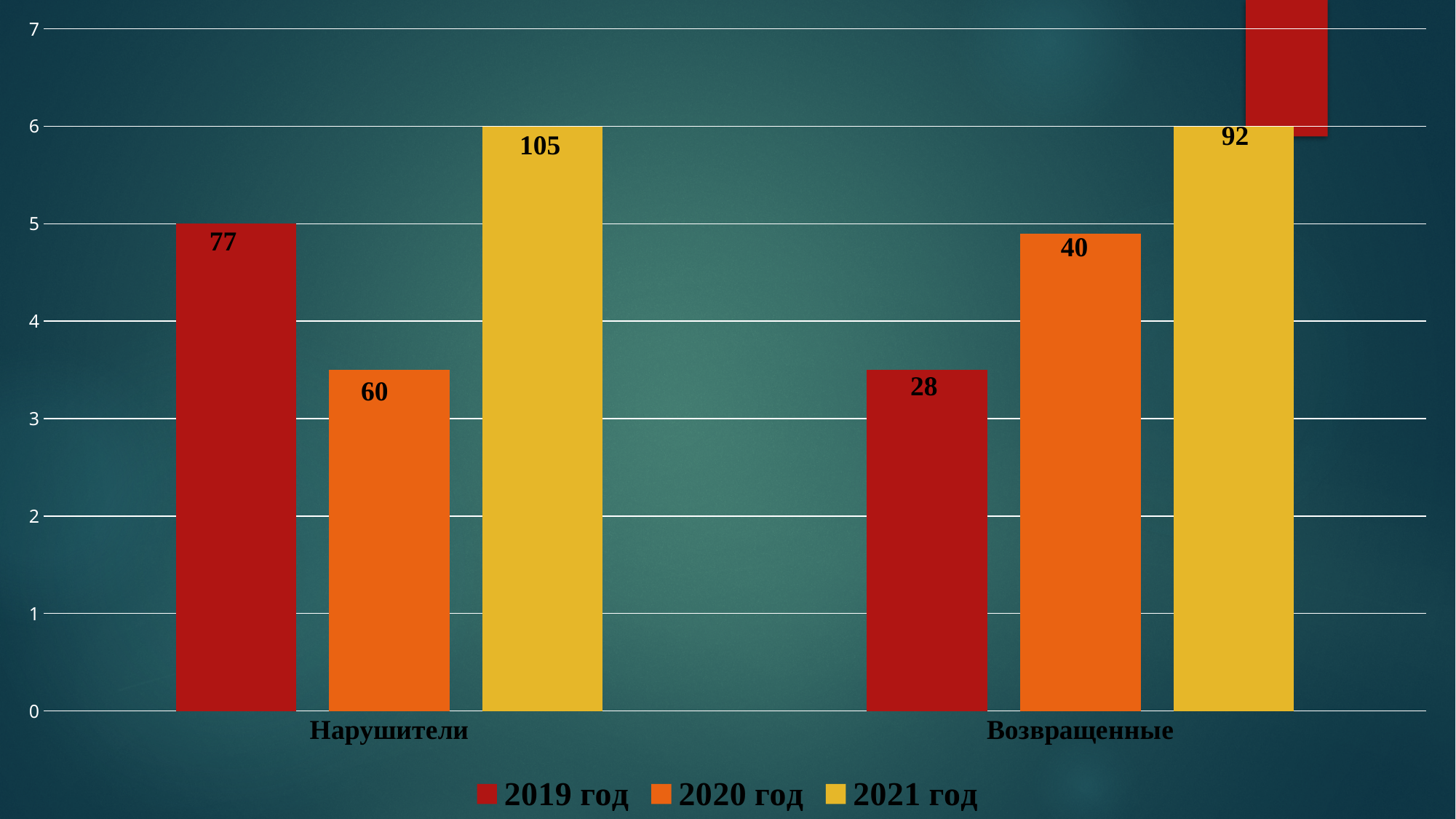
What is the value for 2020 год in the Возвращенные category? 40 Which year has the lowest value in the Возвращенные category? 2019 год What kind of chart is shown on the slide? Bar chart How many categories are shown on the x axis? 2 Which year has the highest value in the Нарушители category? 2021 год Which is larger: the 2019 год value for Нарушители or the 2019 год value for Возвращенные? Нарушители What is the value for 2021 год in the Нарушители category? 105 What is the value for 2019 год in the Возвращенные category? 28 What is the difference between the 2020 год and 2019 год values in the Возвращенные category? 12 What is the difference between the 2021 год and 2019 год values in the Нарушители category? 28 What is the value for 2020 год in the Нарушители category? 60 How many series does the legend list? 3